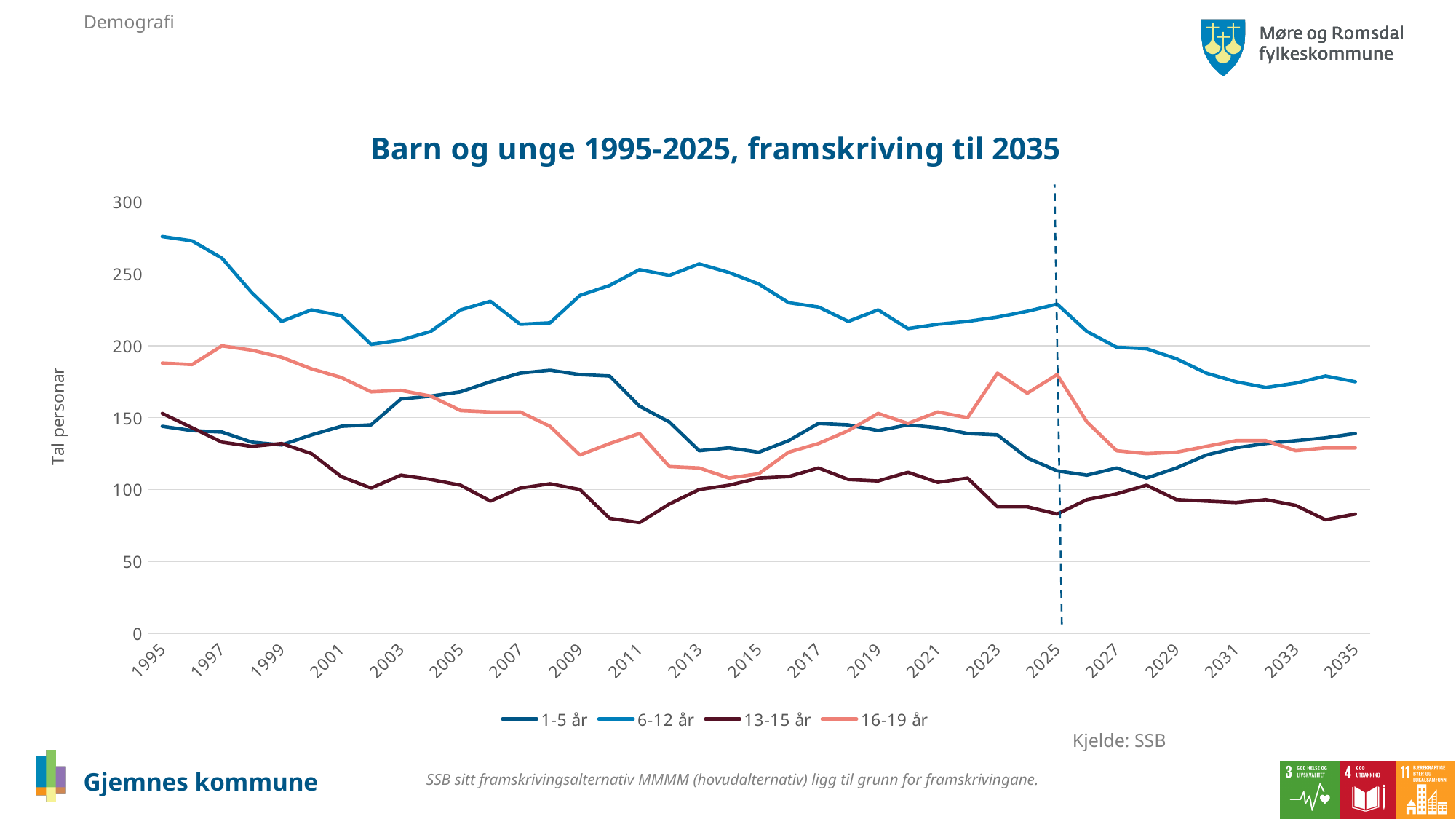
Is the value for 1-5 år in 2008 greater or less than 150? greater Does the 6-12 år series rise or fall from 2025 to 2035? fall Is the value for 6-12 år in 1995 greater or less than 250? greater Is the value for 13-15 år in 2011 greater or less than 100? less Which series has the lowest value in 2011? 13-15 år How many series does the legend list? 4 What is the label on the vertical axis of the chart? Tal personar What is the title of the chart? Barn og unge 1995-2025, framskriving til 2035 In 2023, which is larger: the value for 16-19 år or the value for 1-5 år? 16-19 år Which series has the highest value in 1995? 6-12 år What kind of chart is shown on the slide? line chart